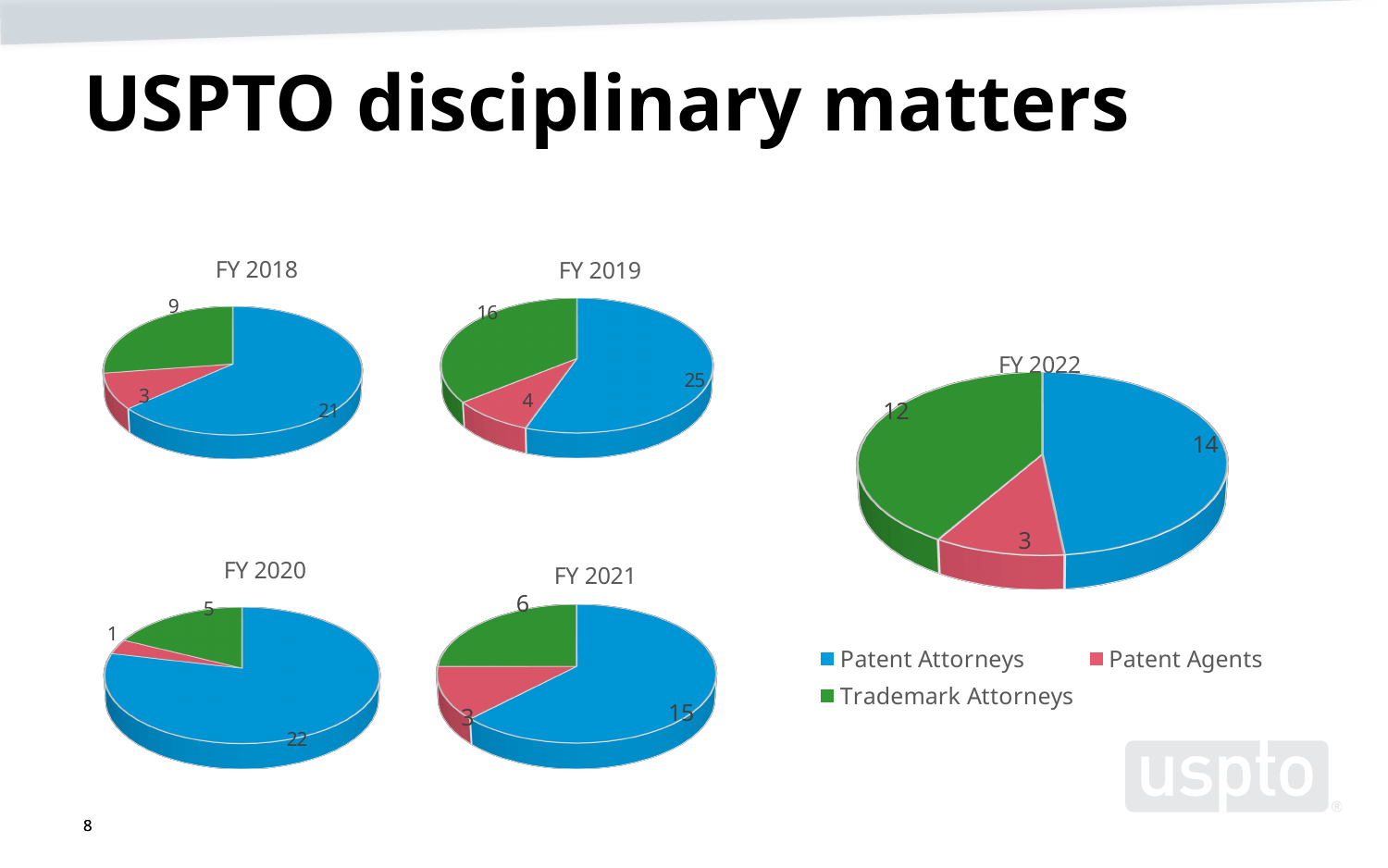
In the FY 2018 chart, what is the value for Patent Attorneys? 21 In the FY 2020 chart, what is the value for Patent Agents? 1 How many series does the legend list? 3 In the FY 2022 chart, what is the value for Trademark Attorneys? 12 In the FY 2019 chart, what is the value for Trademark Attorneys? 16 What kind of chart is used for FY 2020? Pie chart In the FY 2018 chart, which is larger, Trademark Attorneys or Patent Agents? Trademark Attorneys Which colour represents Patent Agents in the legend? Red In the FY 2022 chart, what is the difference between Patent Attorneys and Trademark Attorneys? 2 In the FY 2021 chart, what share of the total do Patent Attorneys represent? 62.5% In the FY 2019 chart, which category has the smallest slice? Patent Agents In the FY 2021 chart, which category has the largest slice? Patent Attorneys